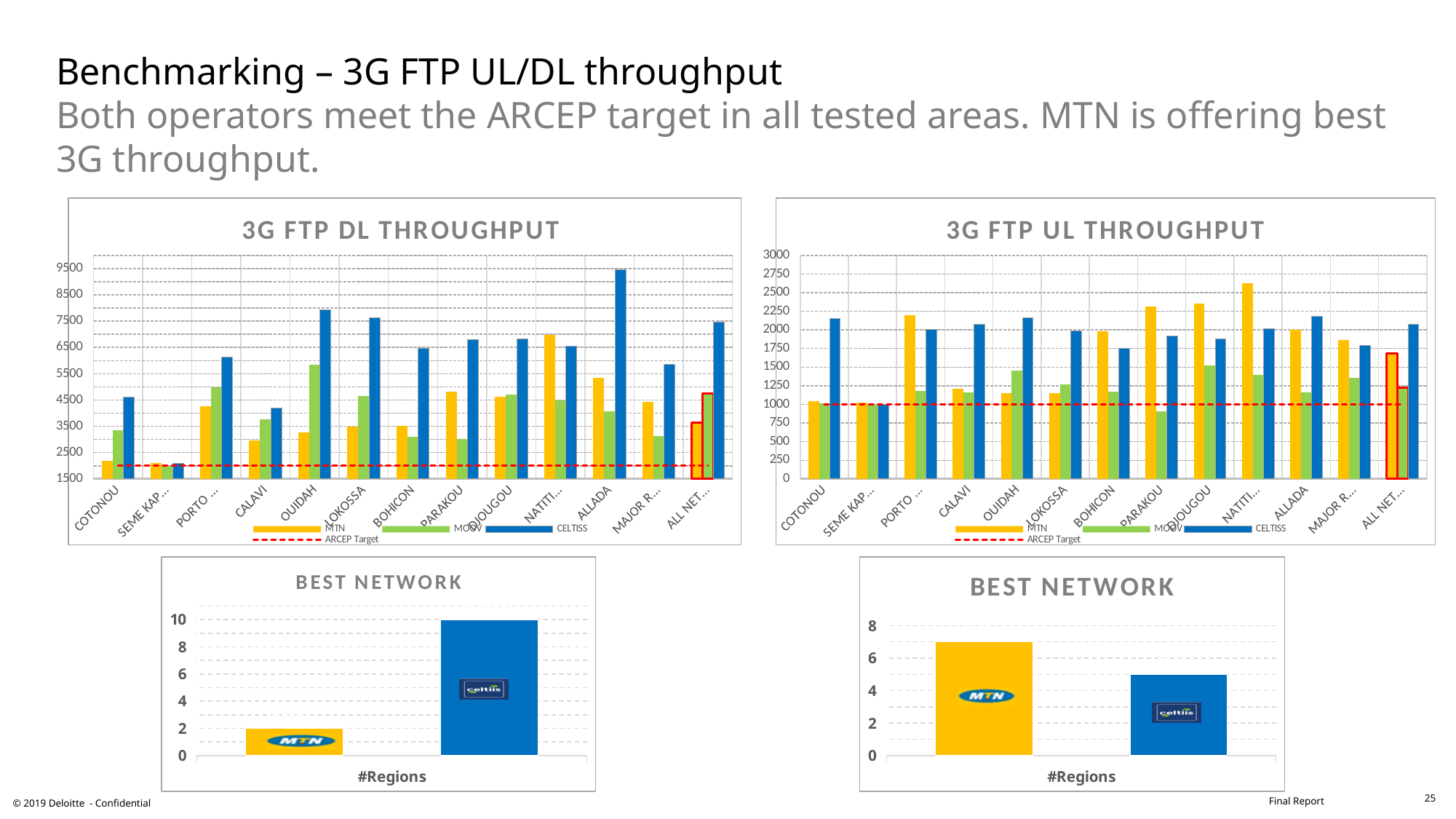
In the bottom-left BEST NETWORK chart, what is the difference between the Celtiis and MTN bars? 8 In the bottom-left BEST NETWORK chart, how many regions does MTN win? 2 In the 3G FTP DL THROUGHPUT chart, is the MTN value for COTONOU greater or less than 2500? less In the 3G FTP UL THROUGHPUT chart, is the MOOV value for PARAKOU greater or less than 1000? less How many entries does the legend of the 3G FTP UL THROUGHPUT chart list? 4 How many categories are shown on the x axis of the 3G FTP DL THROUGHPUT chart? 13 What kind of chart is the 3G FTP DL THROUGHPUT chart? Combination bar and line chart (bars with a dashed ARCEP Target line) In the 3G FTP UL THROUGHPUT chart, is the MTN value for NATITI... greater or less than 2500? greater In the bottom-left BEST NETWORK chart, how many regions does Celtiis win? 10 In the bottom-right BEST NETWORK chart, which operator has the taller bar? MTN